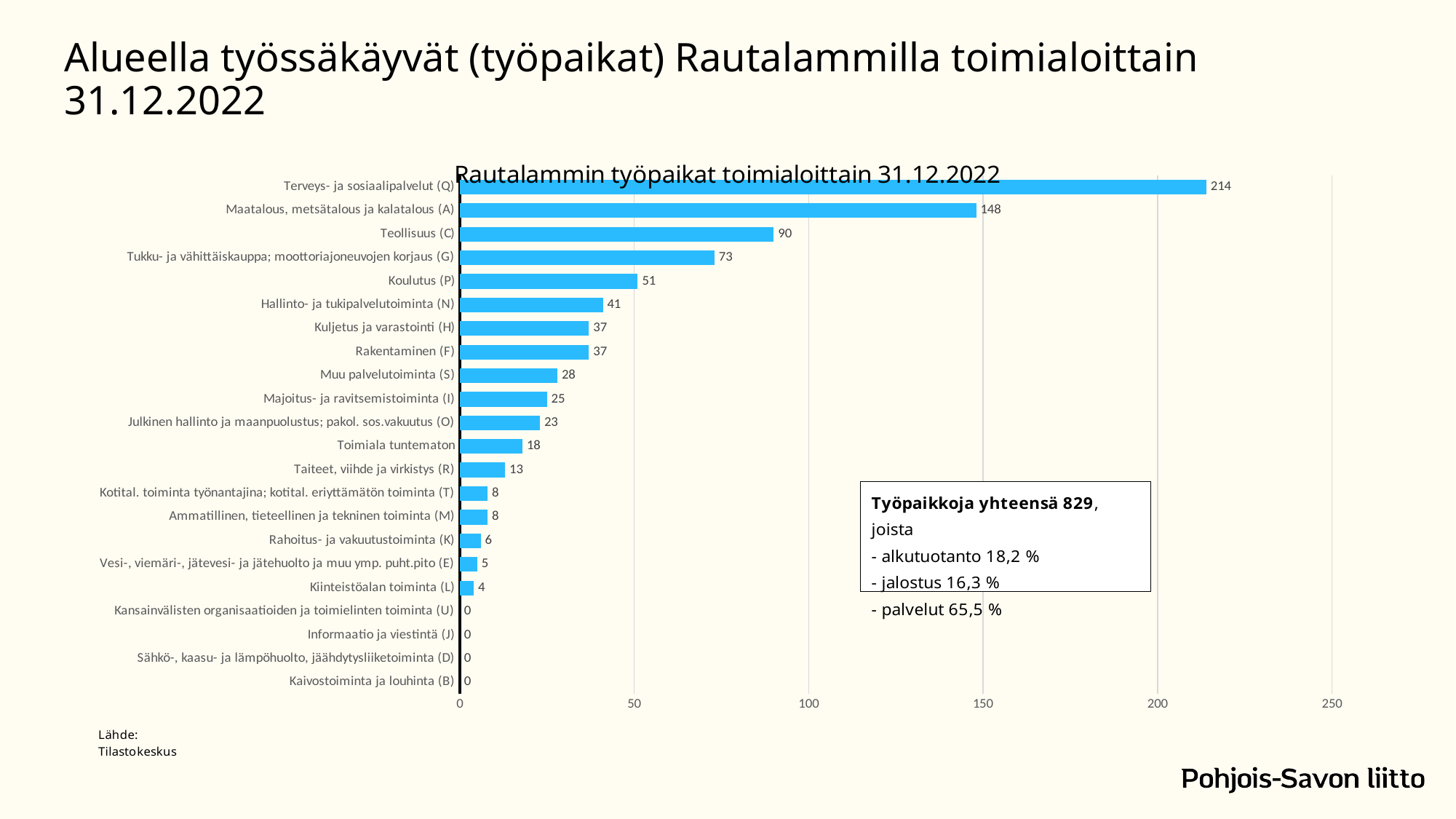
What is the difference between Terveys- ja sosiaalipalvelut (Q) and Maatalous, metsätalous ja kalatalous (A)? 66 Is the value for Maatalous, metsätalous ja kalatalous (A) greater or less than 100? greater What is the title of the chart? Rautalammin työpaikat toimialoittain 31.12.2022 Which category has the highest value? Terveys- ja sosiaalipalvelut (Q) What is the value for Koulutus (P)? 51 What is the value for Teollisuus (C)? 90 How many categories are shown in the chart? 22 Which is larger, Tukku- ja vähittäiskauppa; moottoriajoneuvojen korjaus (G) or Hallinto- ja tukipalvelutoiminta (N)? Tukku- ja vähittäiskauppa; moottoriajoneuvojen korjaus (G) What is the value for Taiteet, viihde ja virkistys (R)? 13 What type of chart is shown on the slide? bar chart What is the value for Terveys- ja sosiaalipalvelut (Q)? 214 What is the value for Kaivostoiminta ja louhinta (B)? 0